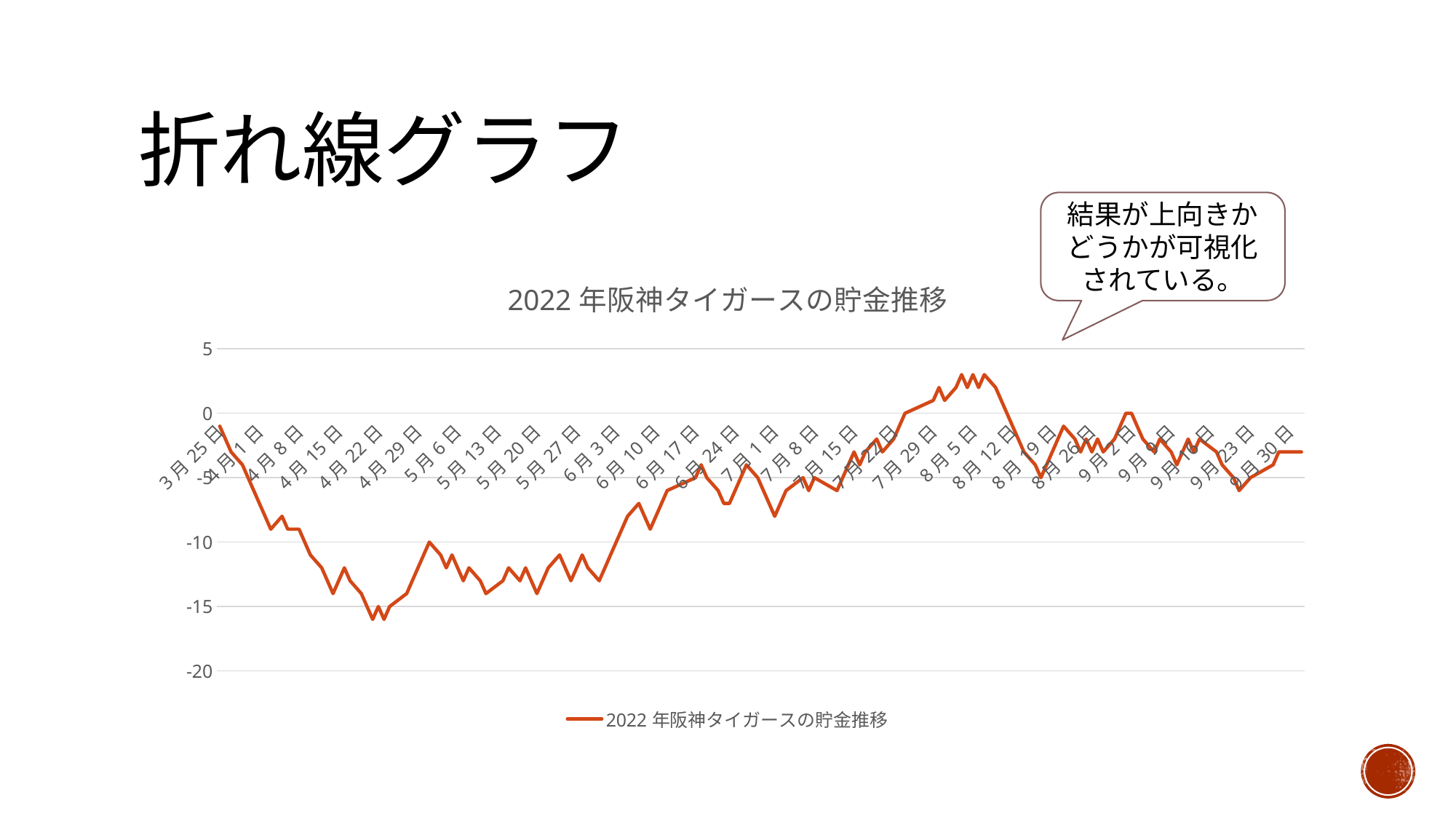
Is the value for 4月8日 greater or less than -5? less Is the value for 9月30日 greater or less than -5? greater Is the value for 4月22日 greater or less than -10? less What is the title of the chart? 2022 年阪神タイガースの貯金推移 What is the lowest value shown on the vertical axis? -20 Does the line rise or fall overall from 6月3日 to 8月5日? rise Does the line rise or fall from 4月1日 to 4月22日? fall How many series does the legend list? 1 What kind of chart is shown on the slide? line chart